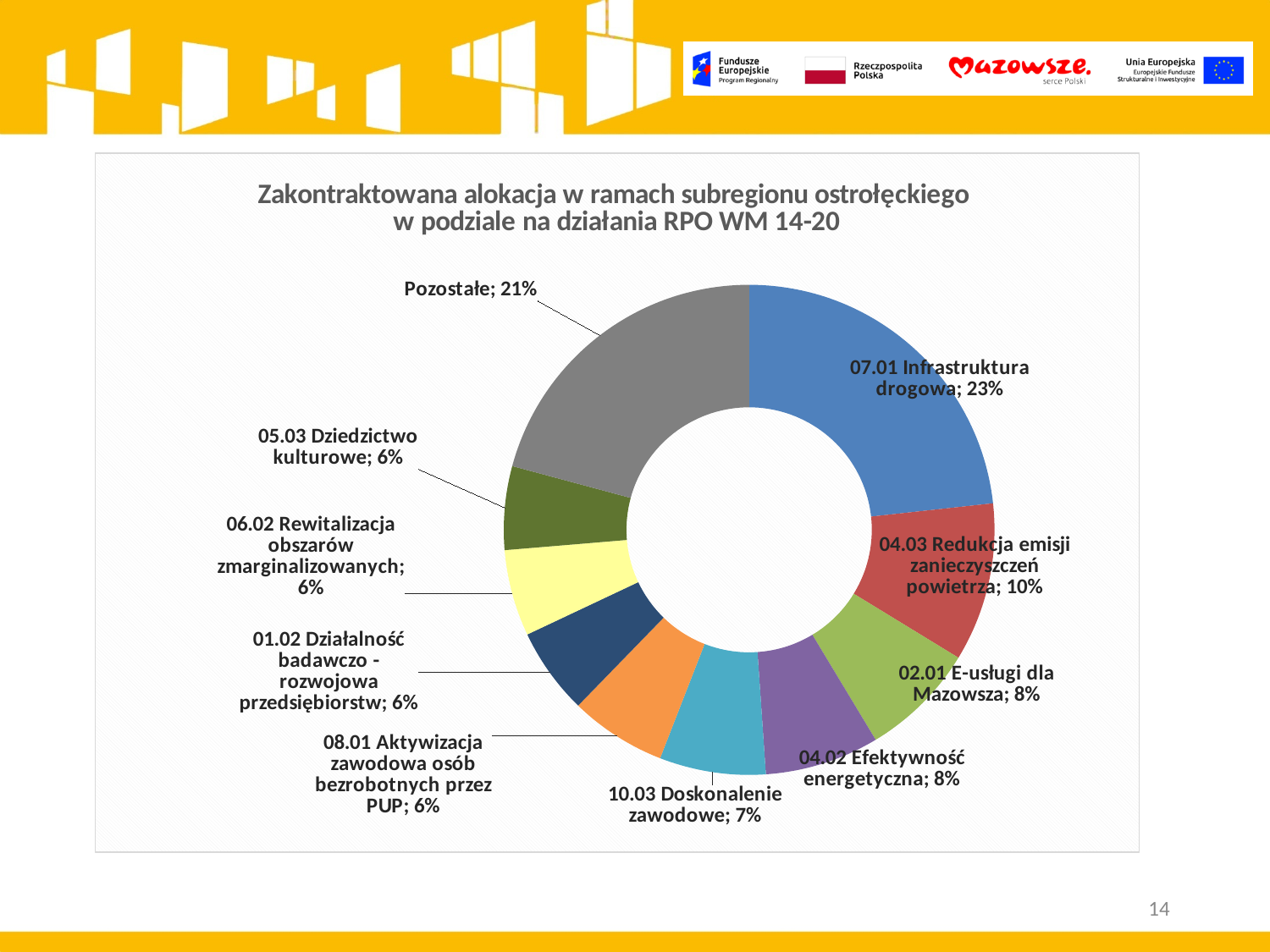
Which named action (excluding Pozostałe) has the largest share of the allocation? 07.01 Infrastruktura drogowa What percentage is shown for 02.01 E-usługi dla Mazowsza? 8% What is the title of the chart? Zakontraktowana alokacja w ramach subregionu ostrołęckiego w podziale na działania RPO WM 14-20 What colour is the Pozostałe slice? Grey What share of the contracted allocation goes to 07.01 Infrastruktura drogowa? 23% What share does 10.03 Doskonalenie zawodowe have? 7% How many slices does the chart have? 10 What percentage is shown for 04.03 Redukcja emisji zanieczyszczeń powietrza? 10% What percentage is shown for the Pozostałe slice? 21% What is the difference in percentage points between 07.01 Infrastruktura drogowa and 04.03 Redukcja emisji zanieczyszczeń powietrza? 13 percentage points Which is larger: the share for 07.01 Infrastruktura drogowa or the share for Pozostałe? 07.01 Infrastruktura drogowa What kind of chart is shown on the slide? Doughnut (pie) chart